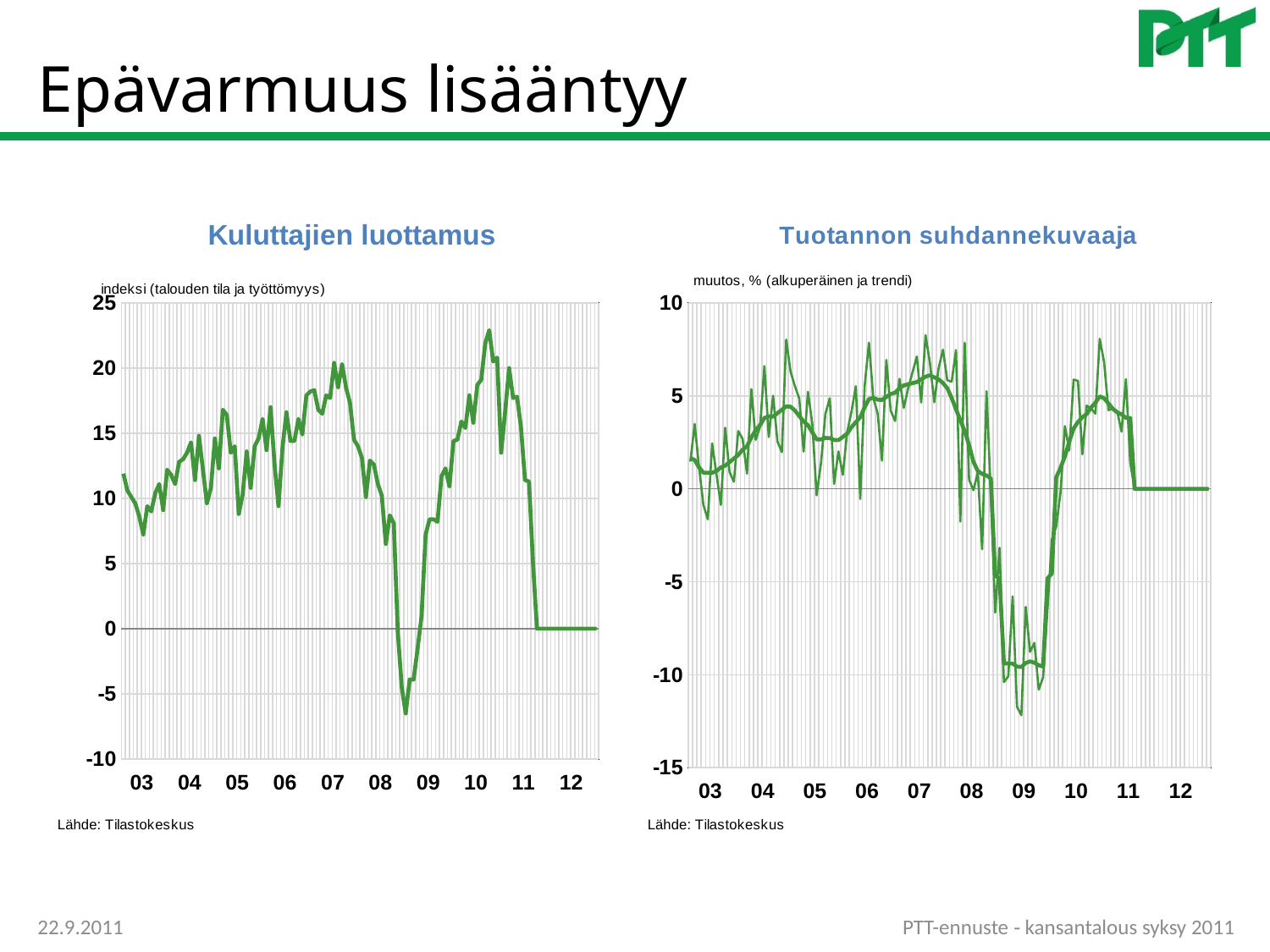
What is the title of the chart on the left of the slide? Kuluttajien luottamus In the "Tuotannon suhdannekuvaaja" chart, is the highest value of the original series greater or less than 5? greater In the "Kuluttajien luottamus" chart, how many year labels are shown on the x axis? 10 What kind of chart is the "Kuluttajien luottamus" chart? line chart In the "Tuotannon suhdannekuvaaja" chart, how many year labels are shown on the x axis? 10 What source is cited below the "Tuotannon suhdannekuvaaja" chart? Tilastokeskus In the "Tuotannon suhdannekuvaaja" chart, is the lowest value reached around 2009 greater or less than -10? less In the "Kuluttajien luottamus" chart, is the lowest value reached around 2009 greater or less than 0? less In the "Kuluttajien luottamus" chart, does the index rise or fall between its 2010 peak and 2011? fall In the "Tuotannon suhdannekuvaaja" chart, do the values rise or fall from 2008 into 2009? fall What kind of chart is the "Tuotannon suhdannekuvaaja" chart? line chart